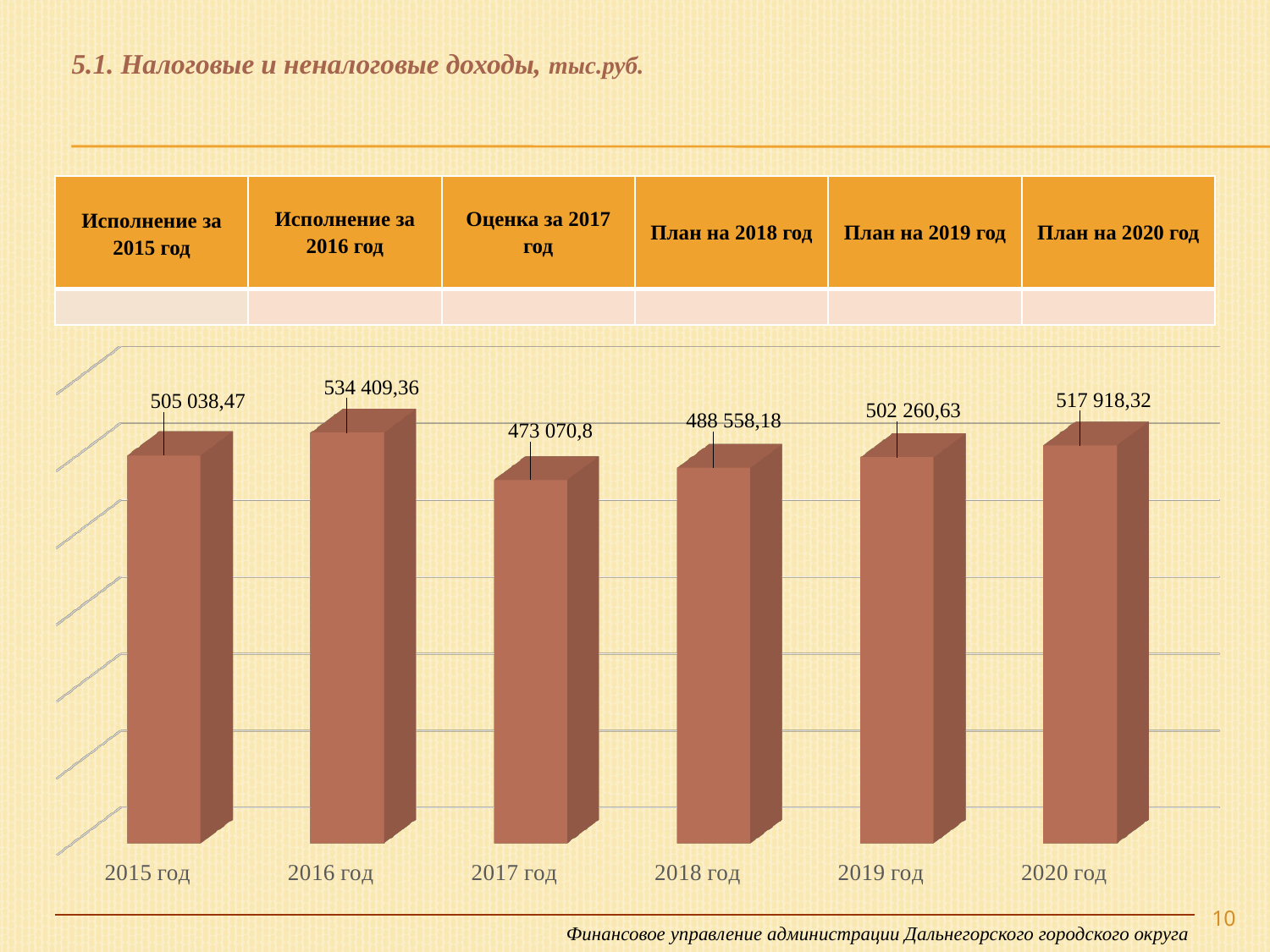
What is the value for 2017 год? 473 070,8 What is the title of the chart on the slide? 5.1. Налоговые и неналоговые доходы, тыс.руб. What is the difference between the values for 2016 год and 2015 год? 29 370,89 Which year has the highest value? 2016 год What is the difference between the values for 2020 год and 2017 год? 44 847,52 What kind of chart is shown on the slide? bar chart Which year has the lowest value? 2017 год Which is larger, the value for 2018 год or the value for 2019 год? 2019 год What is the value for 2015 год? 505 038,47 What is the value for 2020 год? 517 918,32 Do the values rise or fall from 2017 год to 2020 год? rise How many years are shown on the chart? 6